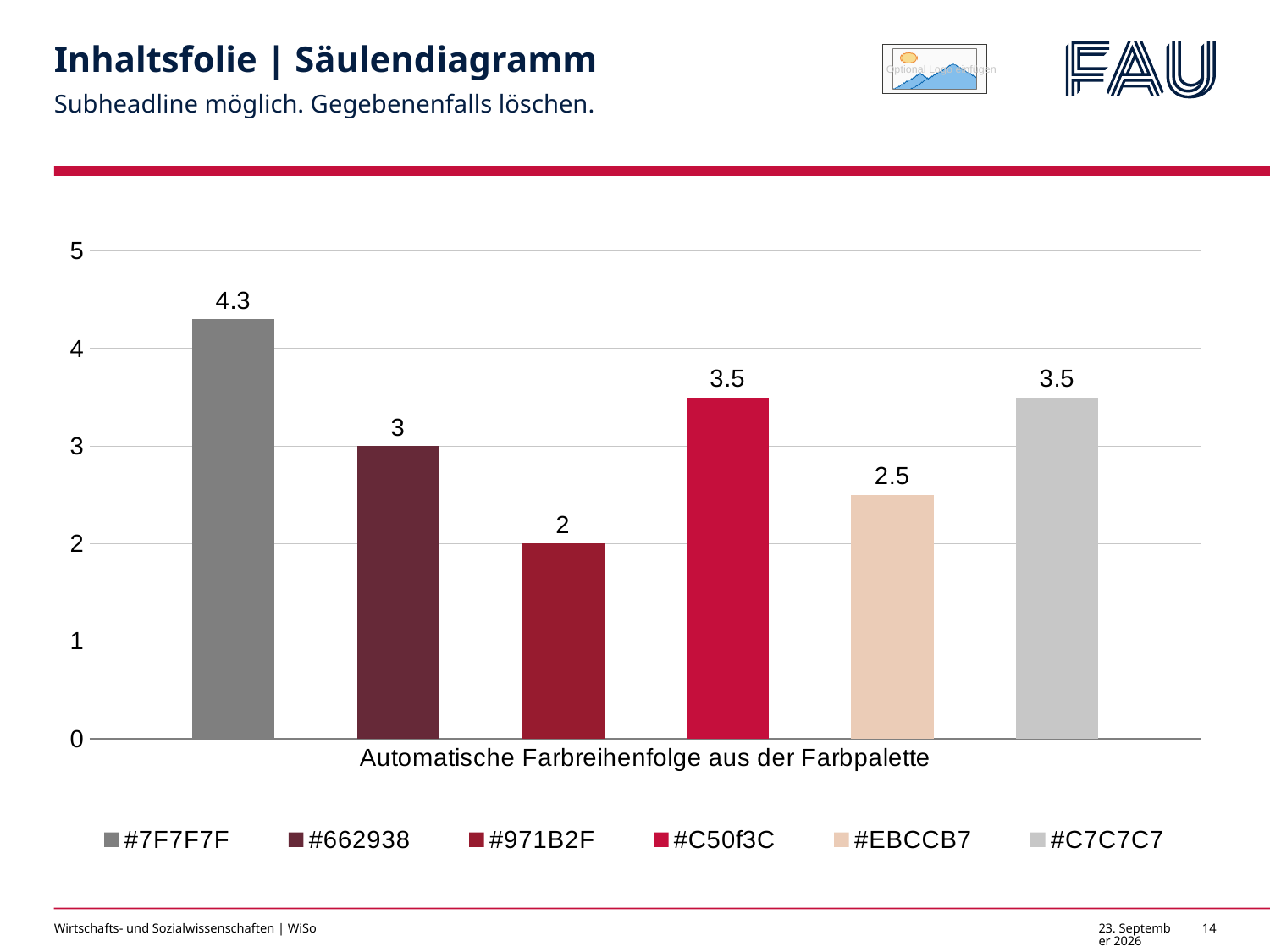
What is the value for the series #EBCCB7? 2.5 What is the difference between the values for #C50f3C and #EBCCB7? 1 What is the difference between the values for #7F7F7F and #971B2F? 2.3 What is the value for the series #7F7F7F? 4.3 Which series has the lowest value? #971B2F How many series does the legend list? 6 Which series has the highest value? #7F7F7F What is the value for the series #662938? 3 What is the value for the series #C50f3C? 3.5 What is the category label shown on the x axis? Automatische Farbreihenfolge aus der Farbpalette Which is larger, the value for #662938 or the value for #EBCCB7? #662938 What kind of chart is shown on the slide? Bar chart